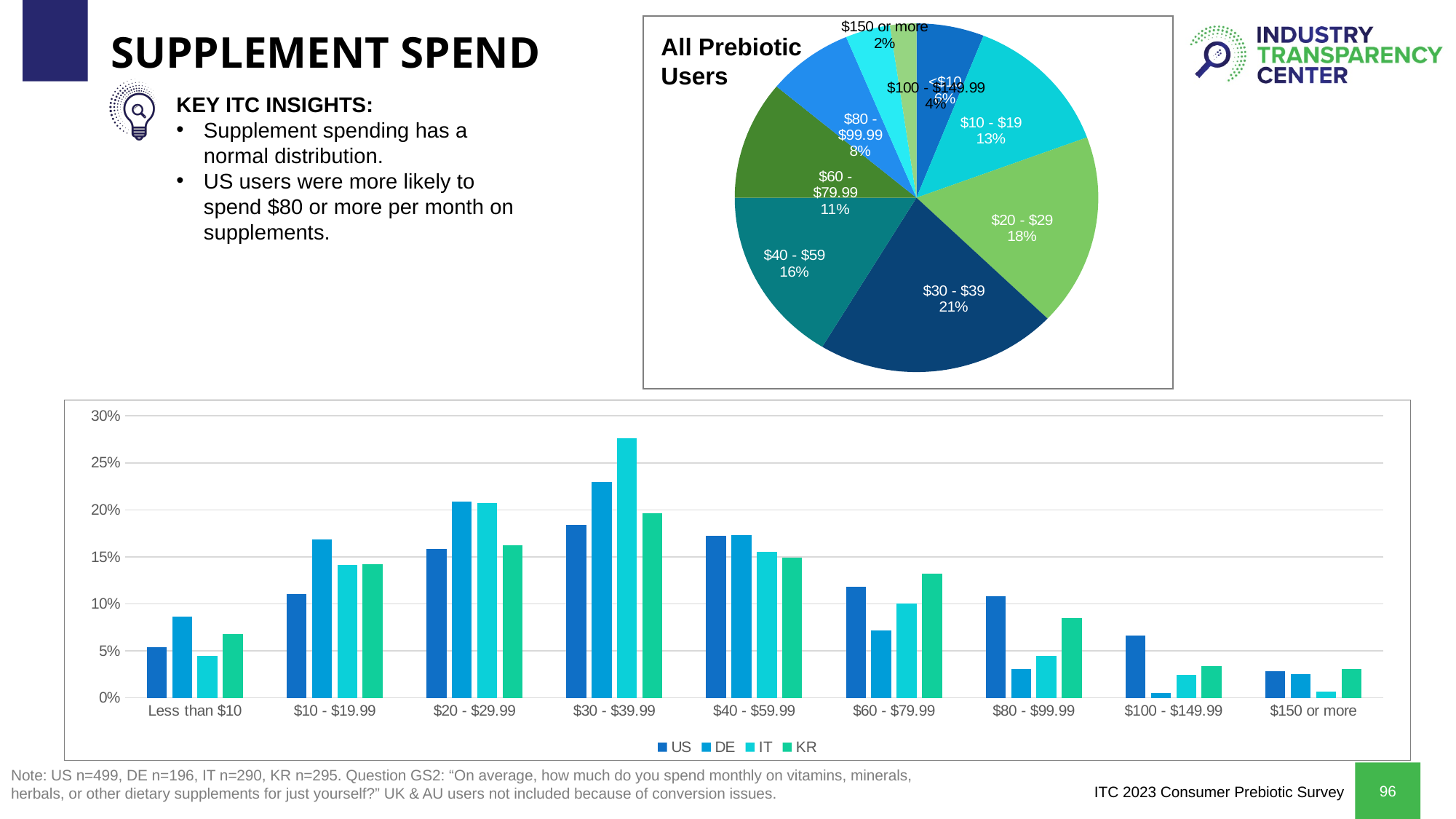
In the bottom bar chart, is the DE value for $80 - $99.99 greater or less than 5%? less In the pie chart titled "All Prebiotic Users", which spending range has the smallest share? $150 or more In the bottom bar chart, is the IT value for $30 - $39.99 greater or less than 25%? greater How many series does the legend of the bottom bar chart list? 4 In the pie chart titled "All Prebiotic Users", which is larger, the $10 - $19 share or the $80 - $99.99 share? $10 - $19 In the pie chart titled "All Prebiotic Users", what share of users spend $150 or more? 2% In the pie chart titled "All Prebiotic Users", what share of users spend $60 - $79.99? 11% In the pie chart titled "All Prebiotic Users", what is the difference between the $20 - $29 share and the $40 - $59 share? 2% In the pie chart titled "All Prebiotic Users", what share of users spend $30 - $39? 21% In the pie chart titled "All Prebiotic Users", which spending range has the largest share? $30 - $39 What kind of chart is the chart at the bottom of the slide? Bar chart How many spending categories are shown on the x axis of the bottom bar chart? 9